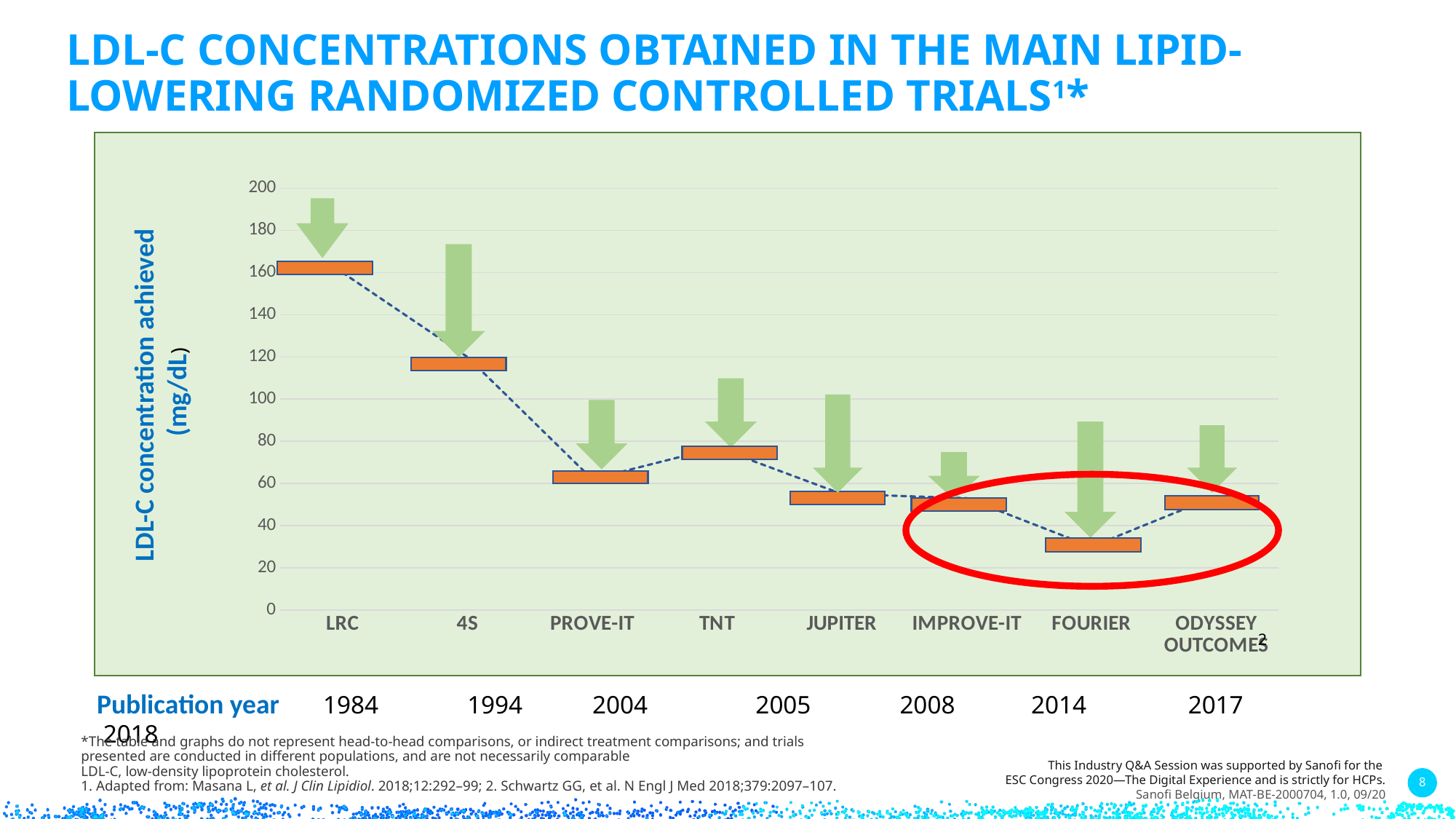
Which trial has the lowest LDL-C concentration achieved? FOURIER What is the label of the y axis of the chart? LDL-C concentration achieved (mg/dL) Which trial achieved a higher LDL-C concentration, TNT or PROVE-IT? TNT Which trial achieved a higher LDL-C concentration, LRC or 4S? LRC Is the LDL-C concentration achieved for 4S greater or less than 140? less Is the LDL-C concentration achieved for FOURIER greater or less than 40? less Is the LDL-C concentration achieved for LRC greater or less than 140? greater Which trial has the highest LDL-C concentration achieved? LRC How many trials are shown on the x axis of the chart? 8 Do the LDL-C concentrations generally rise or fall from LRC to FOURIER along the x axis? fall